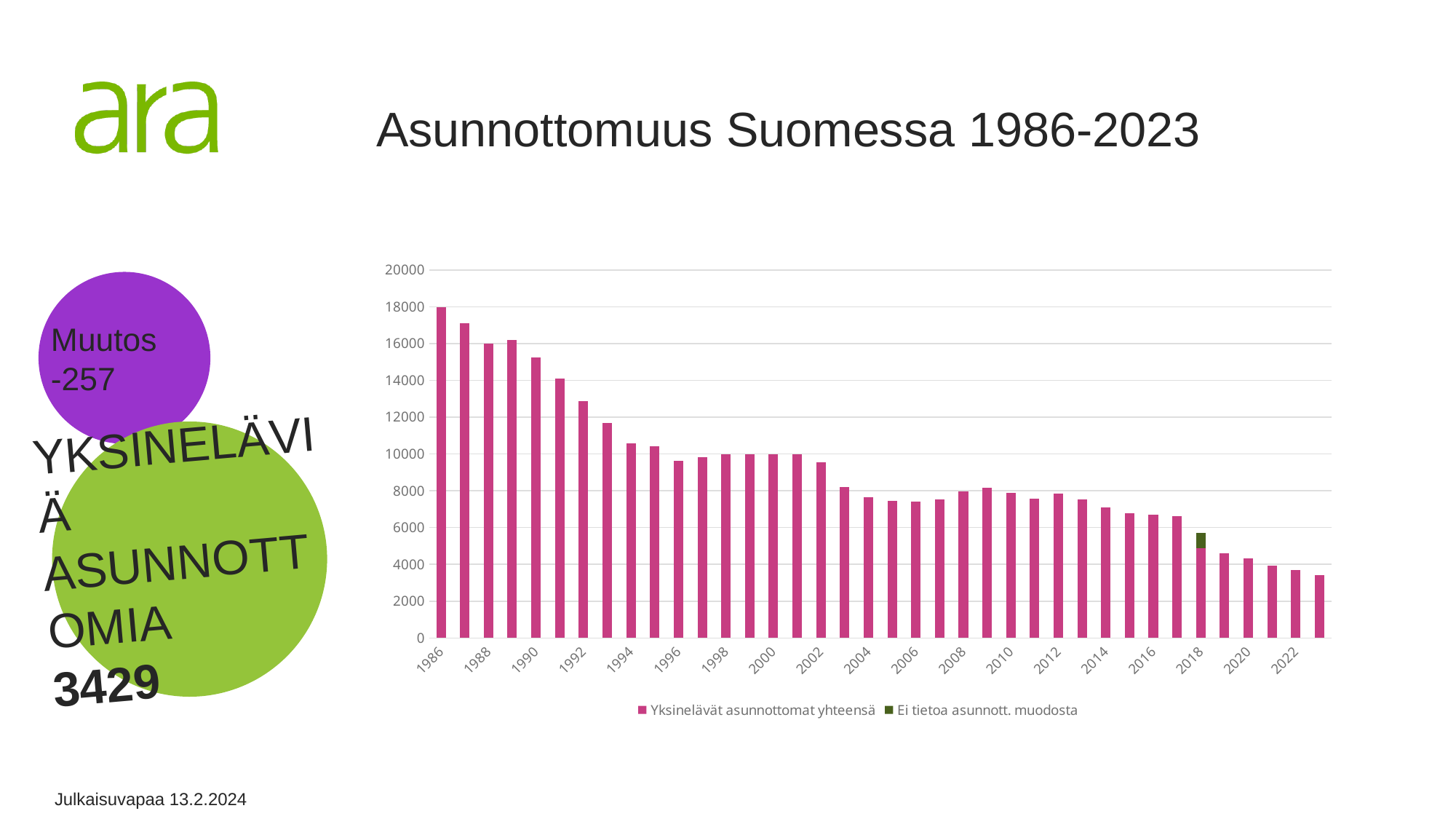
How many series does the legend list? 2 Which year has the lowest value for Yksinelävät asunnottomat yhteensä? 2023 Do the values generally rise or fall from 1986 to 2023? fall What is the title of the chart? Asunnottomuus Suomessa 1986-2023 Is the value for 2020 greater or less than 6000? less Is the value for 2023 greater or less than 4000? less What kind of chart is shown on the slide? bar chart Which year has the highest value for Yksinelävät asunnottomat yhteensä? 1986 Is the value for 1986 greater or less than 16000? greater Which is larger, the value for 1990 or the value for 2000? 1990 Which series is shown in green in the legend? Ei tietoa asunnott. muodosta